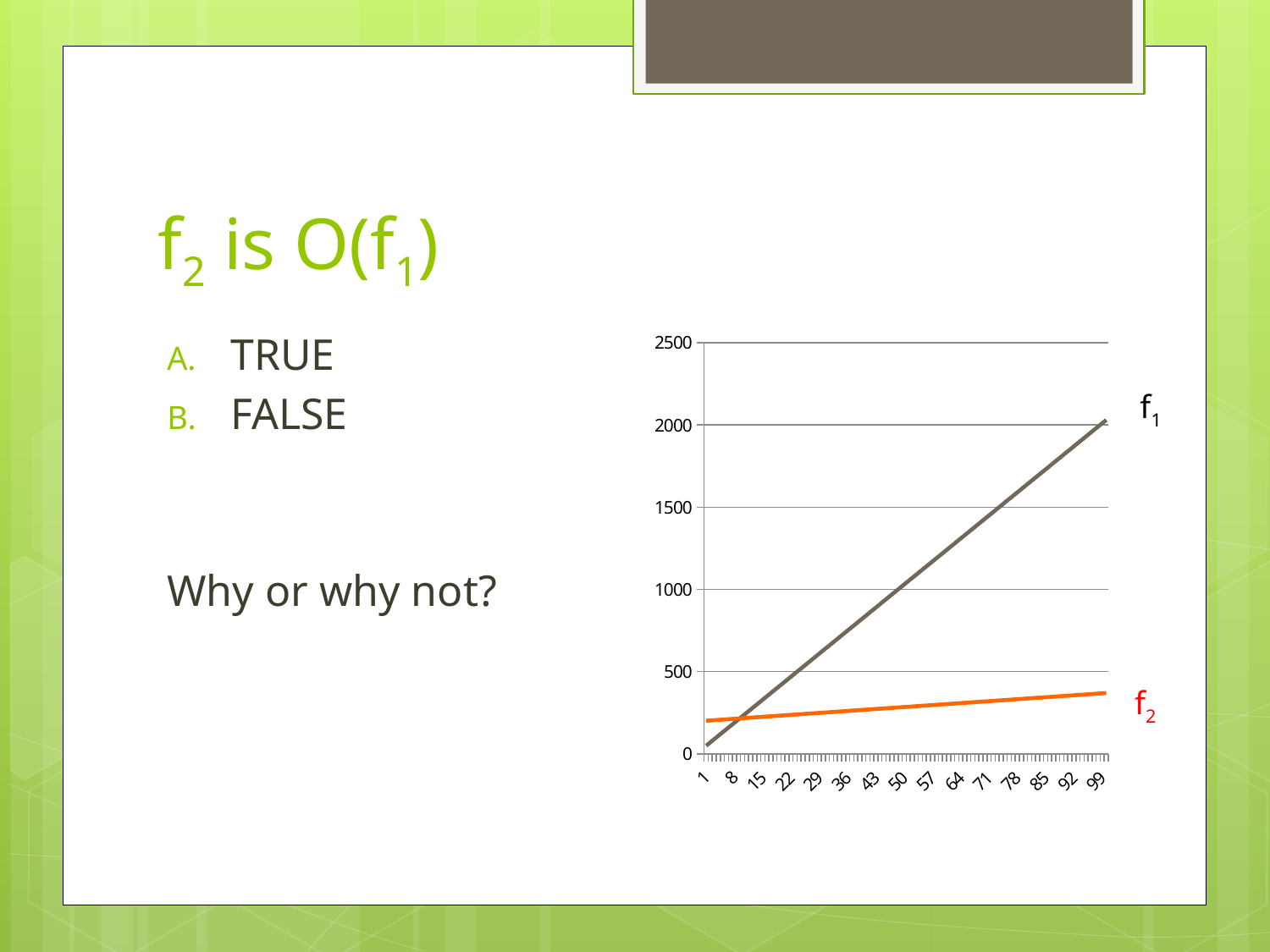
Is the value of f1 at x = 50 greater or less than 500? greater Which series grows more steeply across the x axis, f1 or f2? f1 How many series are plotted on the chart? 2 How many tick labels are shown on the x axis? 15 Is the value of f2 at x = 99 greater or less than 500? less Does the f1 line rise or fall as x increases? rise What kind of chart is shown on the slide? line chart What are the names of the two series plotted on the chart? f1 and f2 Does the f2 line rise or fall as x increases? rise Is the value of f1 at x = 99 greater or less than 1500? greater At x = 99, which series has the larger value, f1 or f2? f1 What is the highest value labelled on the y axis? 2500